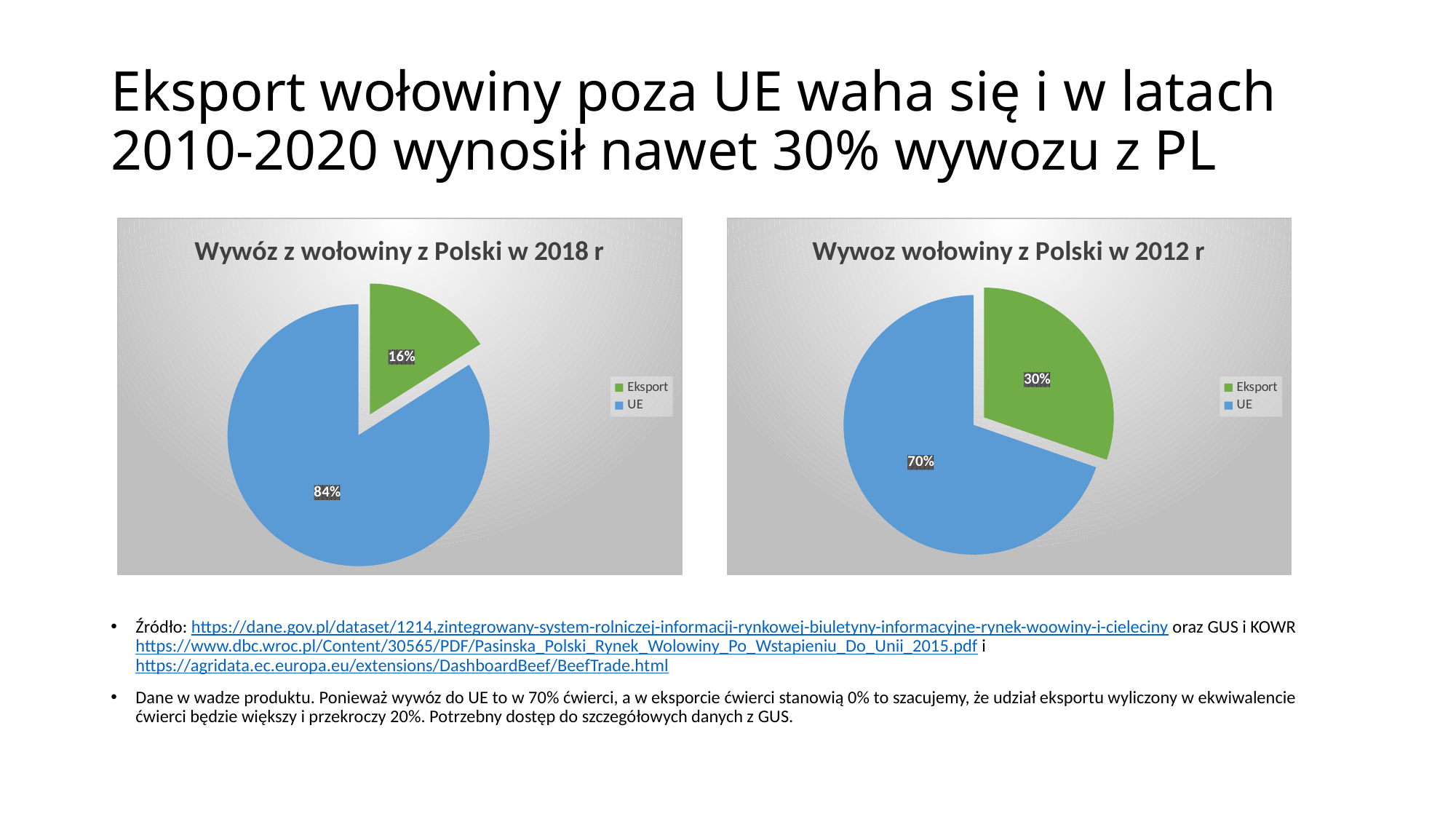
In the chart 'Wywóz z wołowiny z Polski w 2018 r', what share does UE have? 84% Which is larger: the Eksport share in the 2018 chart or the Eksport share in the 2012 chart? 2012 chart In the chart 'Wywóz z wołowiny z Polski w 2018 r', what colour is the Eksport slice? Green How many slices does the chart 'Wywoz wołowiny z Polski w 2012 r' have? 2 In the chart 'Wywóz z wołowiny z Polski w 2018 r', what is the difference between the UE share and the Eksport share? 68% In the chart 'Wywoz wołowiny z Polski w 2012 r', what share does Eksport have? 30% What type of chart is 'Wywóz z wołowiny z Polski w 2018 r'? Pie chart In the chart 'Wywóz z wołowiny z Polski w 2018 r', what share does Eksport have? 16% In the chart 'Wywoz wołowiny z Polski w 2012 r', which slice is the smallest? Eksport In the chart 'Wywóz z wołowiny z Polski w 2018 r', which slice is the largest? UE In the chart 'Wywoz wołowiny z Polski w 2012 r', what is the difference between the UE share and the Eksport share? 40%